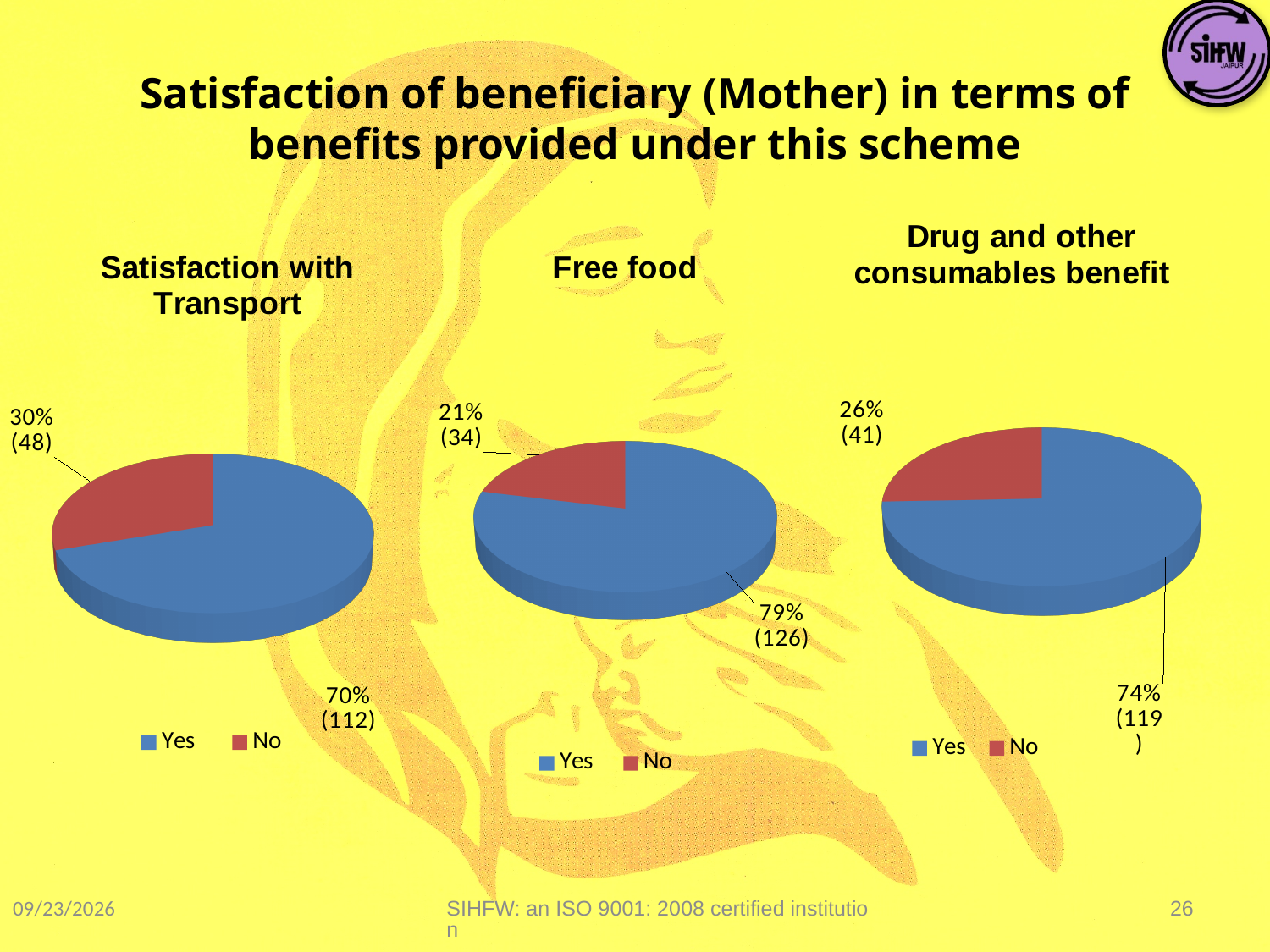
In the 'Drug and other consumables benefit' pie chart, what colour is the Yes slice? Blue In the 'Satisfaction with Transport' pie chart, what percentage of beneficiaries answered Yes? 70% In the 'Satisfaction with Transport' pie chart, how many beneficiaries answered No? 48 In the 'Free food' pie chart, which slice is larger, Yes or No? Yes In the 'Drug and other consumables benefit' pie chart, what percentage of beneficiaries answered No? 26% In the 'Drug and other consumables benefit' pie chart, what is the difference between the number of Yes and No responses? 78 In the 'Satisfaction with Transport' pie chart, what is the difference in percentage points between the Yes and No slices? 40 In the 'Free food' pie chart, what percentage of beneficiaries answered Yes? 79% In the 'Free food' pie chart, how many beneficiaries answered No? 34 How many slices does the 'Satisfaction with Transport' pie chart have? 2 In the 'Drug and other consumables benefit' pie chart, how many beneficiaries answered Yes? 119 What type of chart is used for 'Free food'? Pie chart